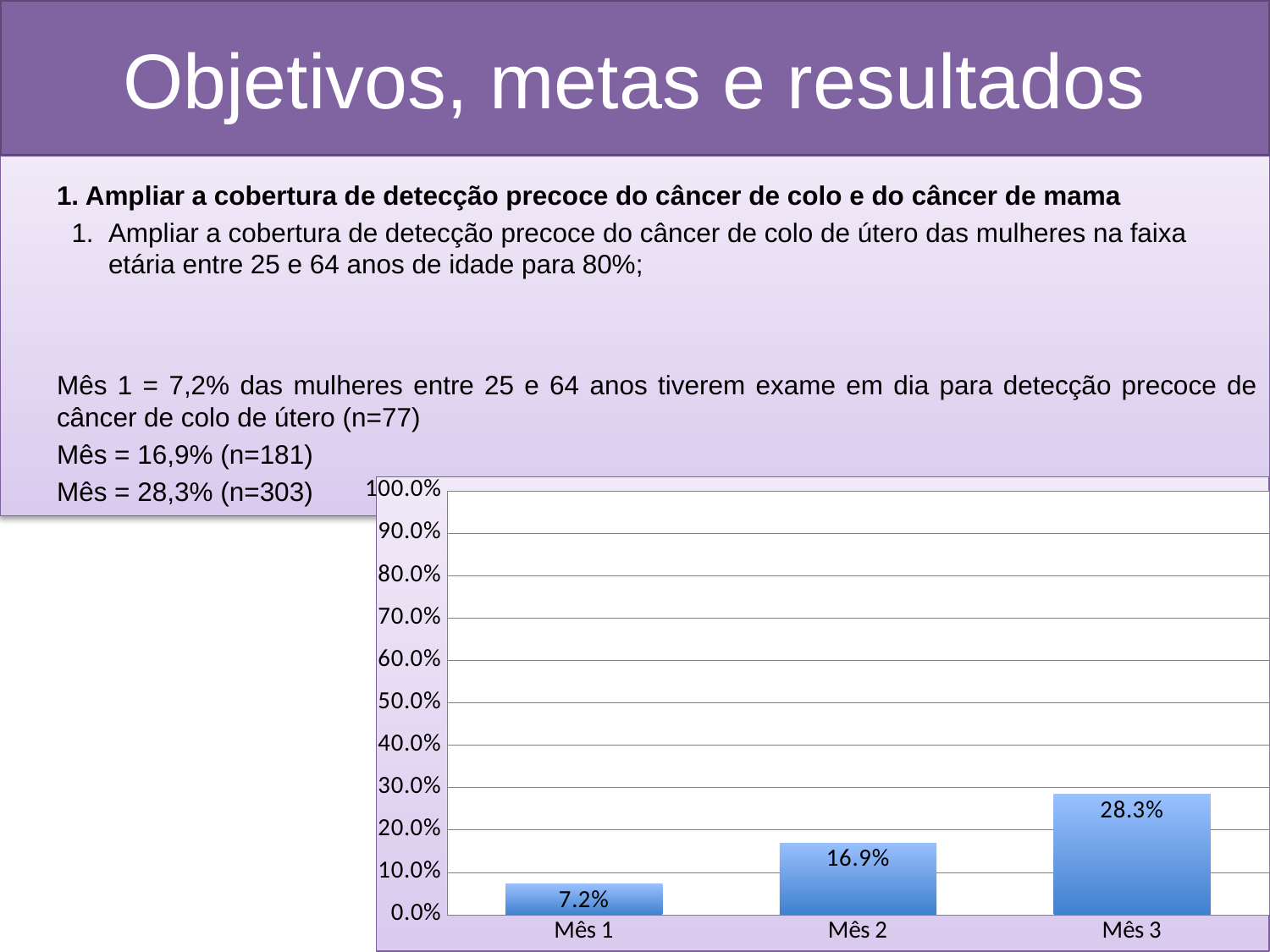
How many categories are shown on the x axis? 3 Do the values rise or fall from Mês 1 to Mês 3? rise Which month has the lowest value? Mês 1 Which is larger, the value for Mês 2 or the value for Mês 3? Mês 3 What is the difference between the values for Mês 3 and Mês 1? 21.1% What is the value for Mês 3? 28.3% What kind of chart is shown on the slide? bar chart What is the value for Mês 2? 16.9% Which month has the highest value? Mês 3 What is the value for Mês 1? 7.2% Is the value for Mês 3 greater or less than 30.0%? less What is the difference between the values for Mês 2 and Mês 1? 9.7%